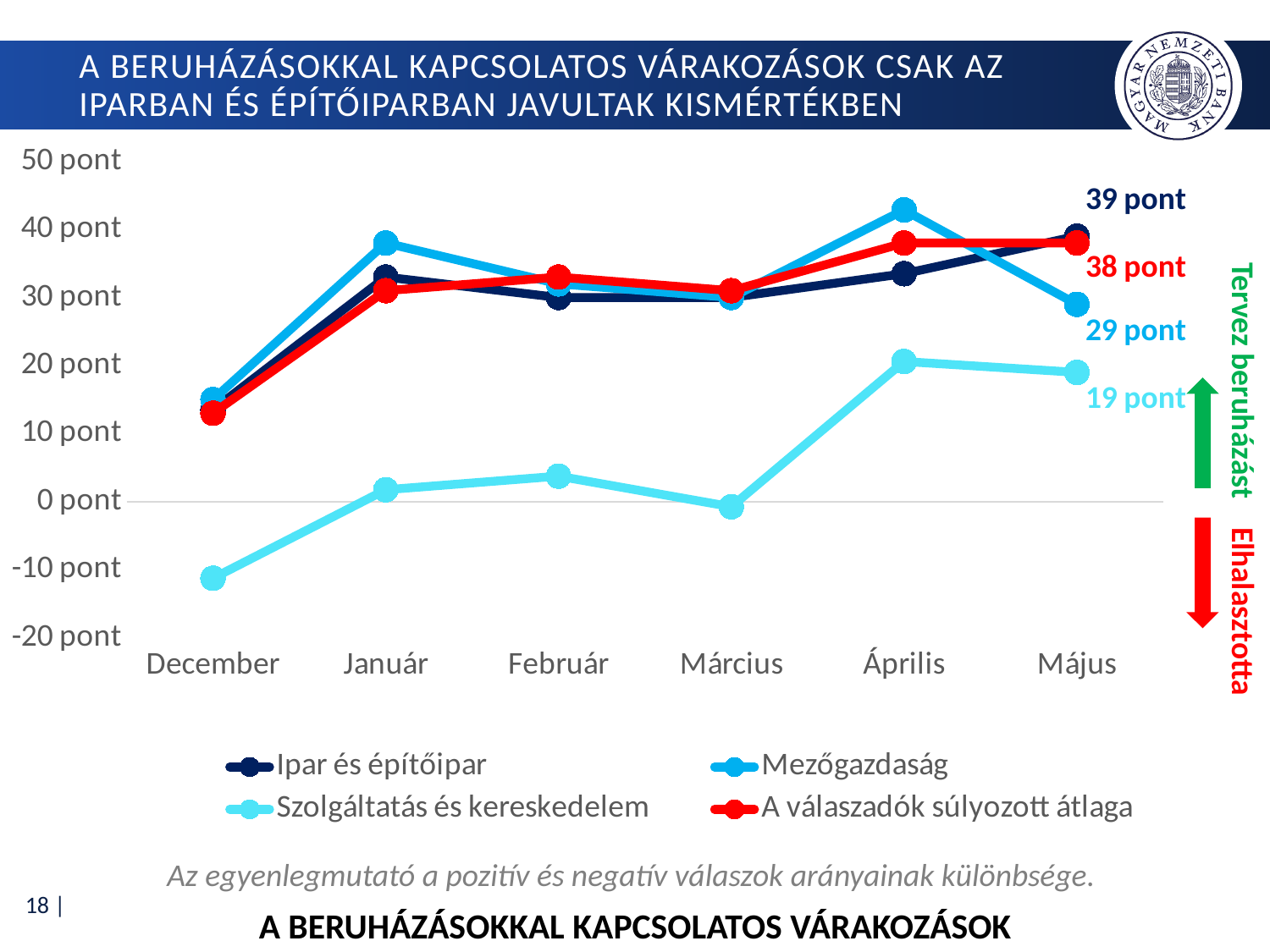
Is the value for Szolgáltatás és kereskedelem in December greater or less than 0 pont? less Does the Szolgáltatás és kereskedelem line rise or fall from December to Április? rise Which series has the highest value in Április? Mezőgazdaság How many series does the legend list? 4 How many months are shown on the x axis? 6 What is the value for Mezőgazdaság in Május? 29 pont Which series has the lowest value in Május? Szolgáltatás és kereskedelem What kind of chart is shown on the slide? line chart What is the value for Ipar és építőipar in Május? 39 pont What is the value for A válaszadók súlyozott átlaga in Május? 38 pont What is the value for Szolgáltatás és kereskedelem in Május? 19 pont What is the difference between the Május values of Ipar és építőipar and Szolgáltatás és kereskedelem? 20 pont